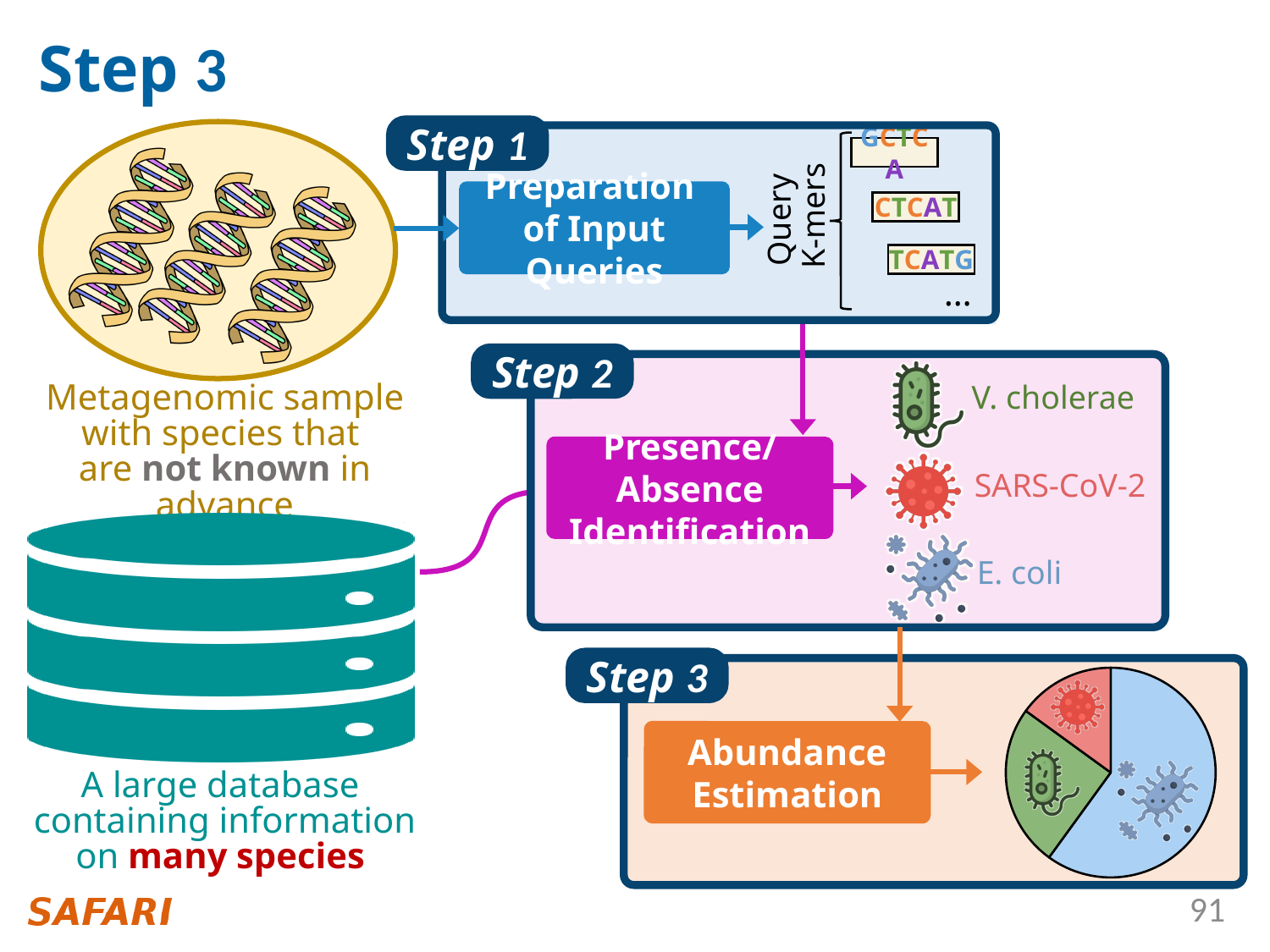
In the Step 3 pie chart, which colour slice is the smallest? red Which process box feeds its output into the pie chart in the Step 3 box? Abundance Estimation In the Step 3 pie chart, which species icon appears in the smallest slice? SARS-CoV-2 What colour is the slice containing the V. cholerae icon in the Step 3 pie chart? green In the Step 3 pie chart, is the blue slice larger or smaller than the green slice? larger In the Step 3 pie chart, is the green slice larger or smaller than the red slice? larger How many slices does the pie chart in the Step 3 box have? 3 What kind of chart is shown in the Step 3 box? pie chart In the Step 3 pie chart, which colour slice is the largest? blue In the Step 3 pie chart, which species icon appears in the largest slice? E. coli